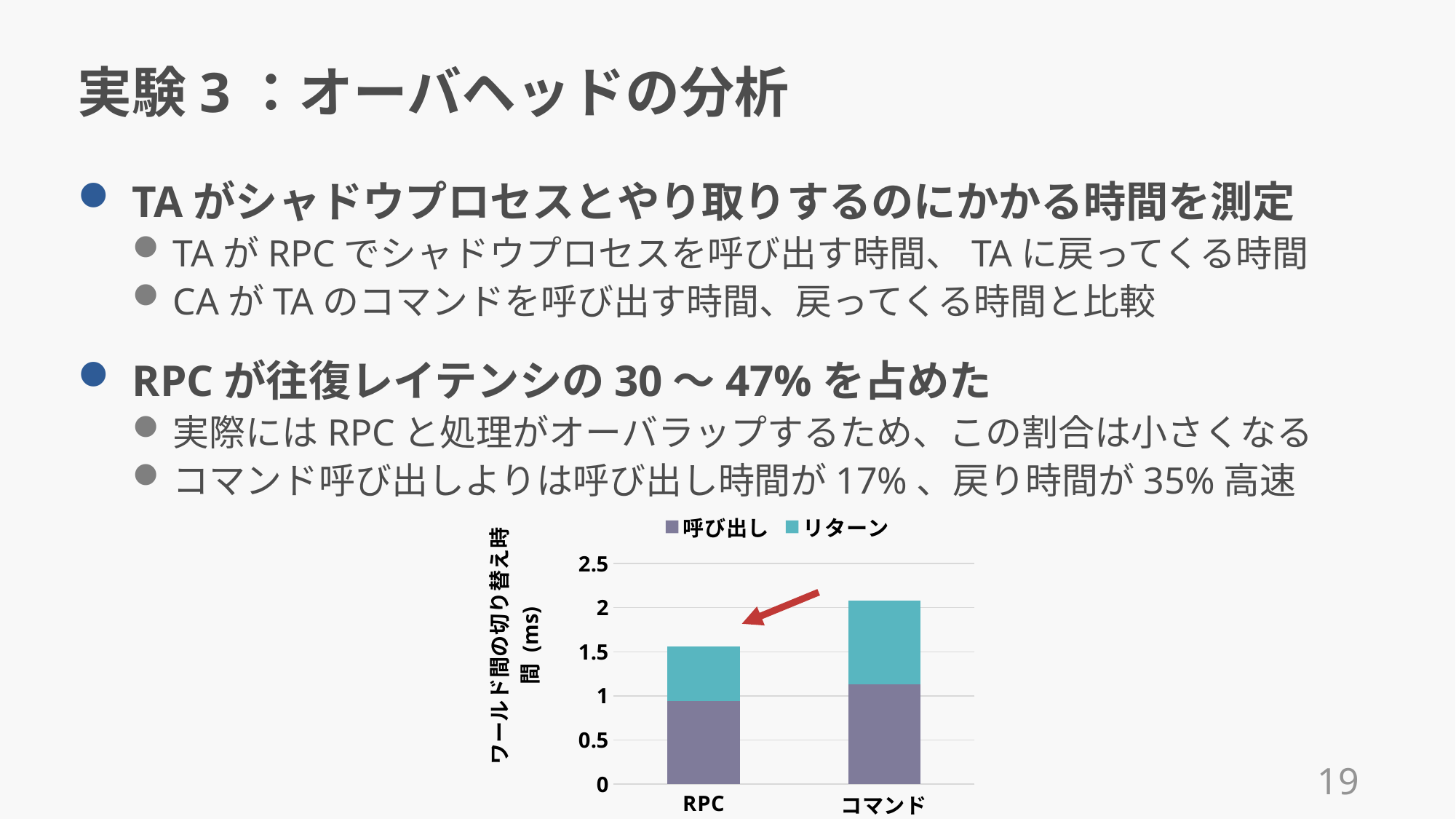
Is the 呼び出し value for コマンド greater or less than 1? greater Which category has the taller stacked bar, RPC or コマンド? コマンド How many categories are shown on the x axis of the chart? 2 What is the label of the chart's vertical axis? ワールド間の切り替え時間 (ms) What kind of chart is shown on the slide? stacked bar chart What are the two series listed in the chart's legend? 呼び出し and リターン Is the 呼び出し value for RPC greater or less than 1? less Which category has the larger 呼び出し segment, RPC or コマンド? コマンド How many series does the chart's legend list? 2 Is the total stacked value for RPC greater or less than 2? less Which category has the lowest total switching time? RPC